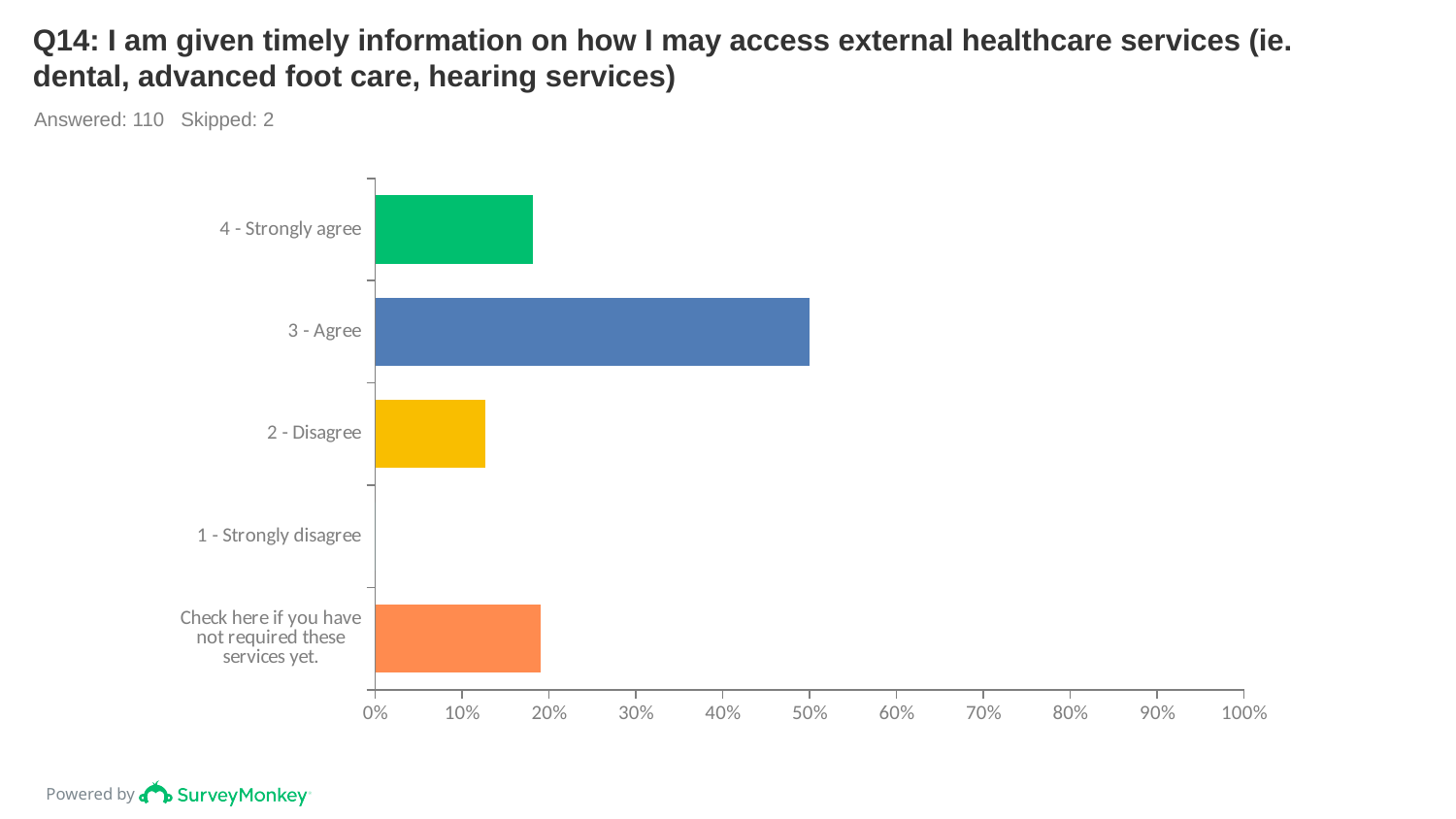
What is the value for 1 - Strongly disagree? 0% What is the value for 3 - Agree? 50% How many respondents answered this question according to the slide? 110 What kind of chart is shown on the slide? bar chart Which is larger, the value for 3 - Agree or the value for 2 - Disagree? 3 - Agree Is the value for 2 - Disagree greater or less than 10%? greater Which response category has the lowest value? 1 - Strongly disagree How many response categories are shown on the chart? 5 Which response category has the highest value? 3 - Agree Is the value for 4 - Strongly agree greater or less than 20%? less How many respondents skipped this question according to the slide? 2